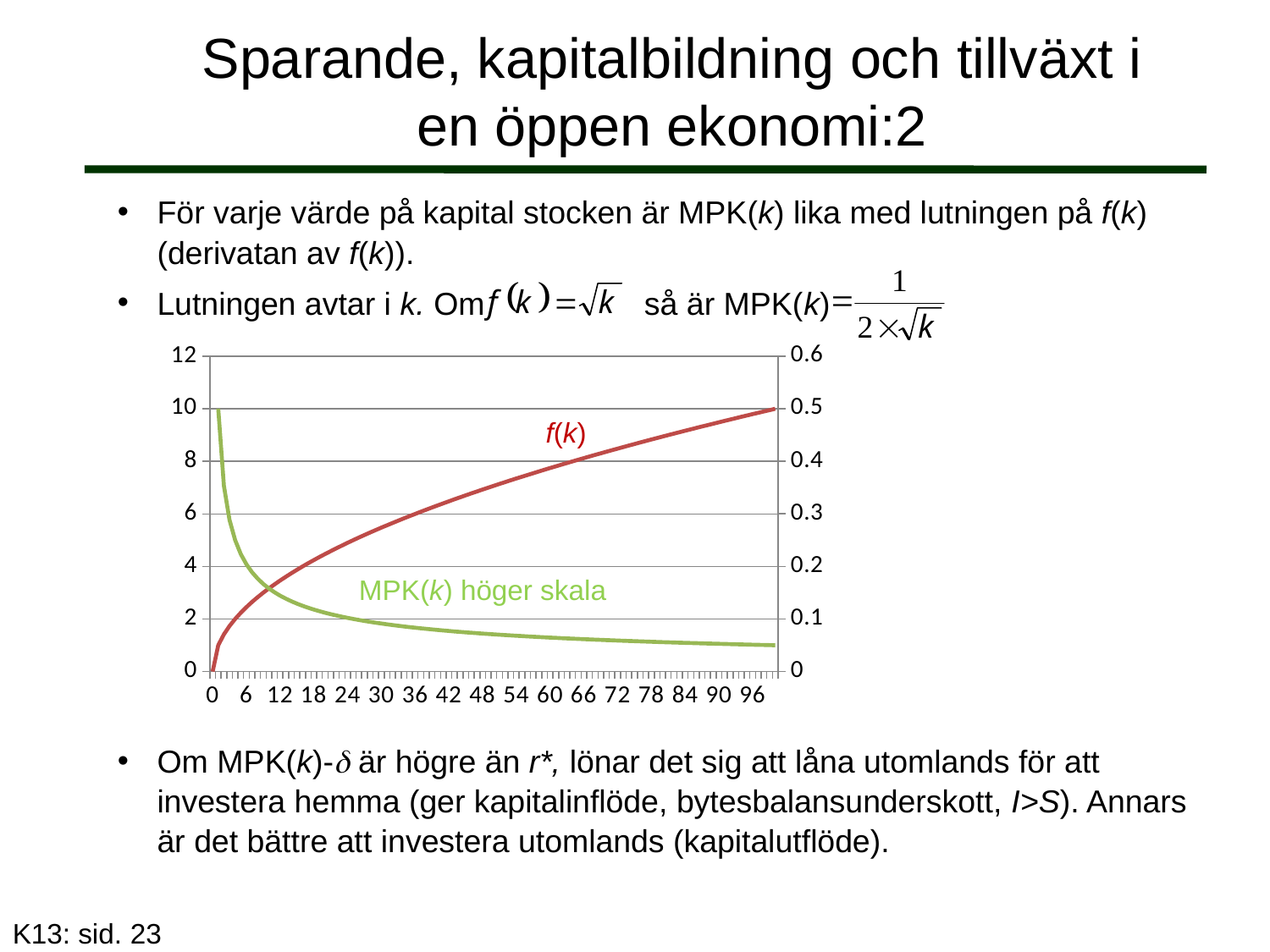
What colour is the f(k) curve? red Does the MPK(k) curve rise or fall as k increases along the x axis? falls Is the value of f(k) at k = 90 greater or less than 8 on the left scale? greater What kind of chart is shown on the slide? line chart Which axis scale does the MPK(k) curve use, according to its label? the right scale (höger skala) Is the value of f(k) at k = 36 greater or less than 4 on the left scale? greater Does the f(k) curve rise or fall as k increases along the x axis? rises Is the value of f(k) at k = 12 greater or less than 6 on the left scale? less How many curves are plotted in the chart? 2